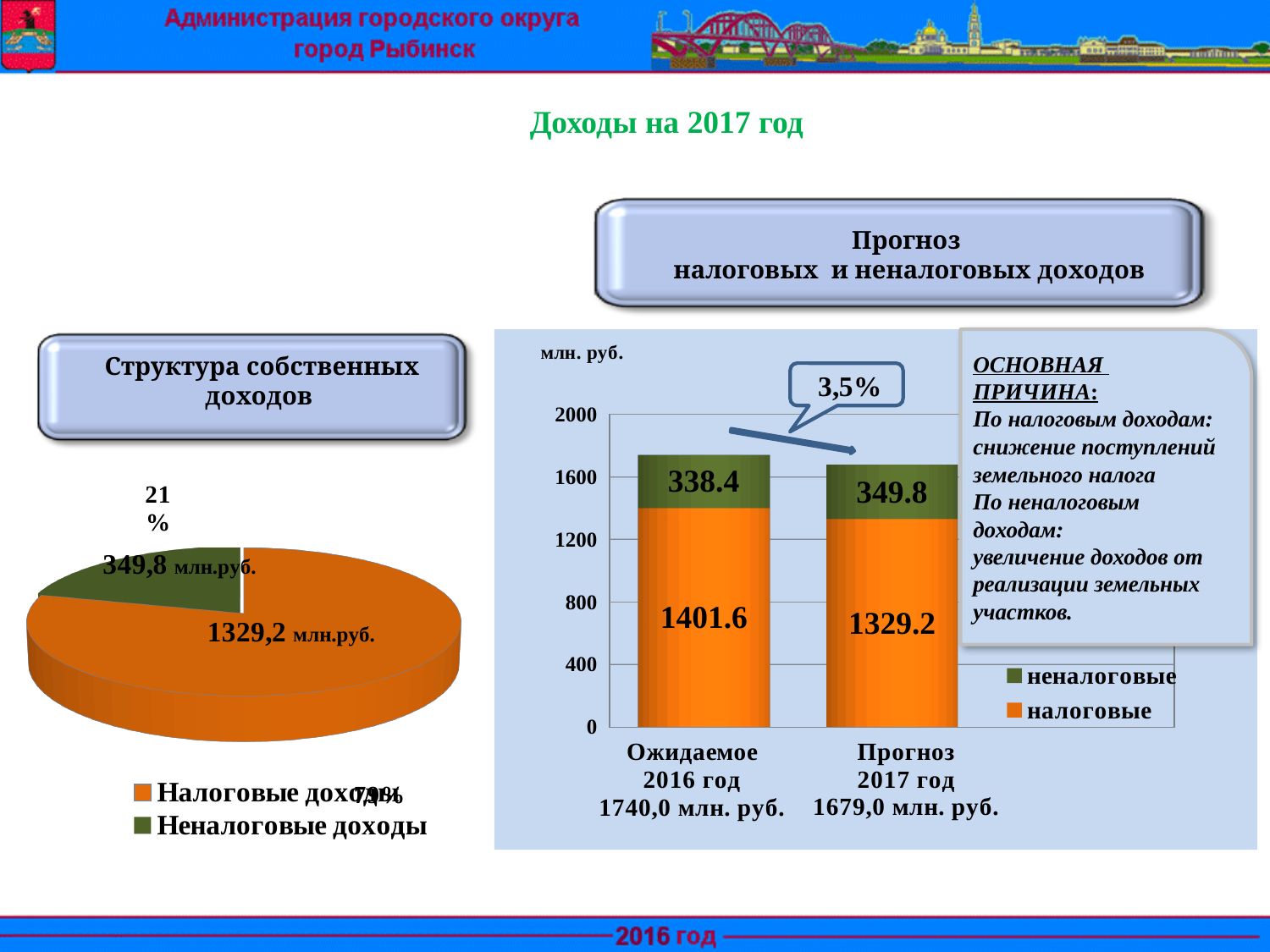
In the bar chart on the right, what is the value of неналоговые for Прогноз 2017 год? 349.8 In the bar chart on the right, what is the total shown for Ожидаемое 2016 год? 1740,0 млн. руб. In the bar chart on the right, what is the total shown for Прогноз 2017 год? 1679,0 млн. руб. In the bar chart on the right, what is the difference between the налоговые values for 2016 and 2017? 72.4 In the bar chart on the right, what percentage change is shown in the callout above the bars? 3,5% In the pie chart on the left, what share of the pie is Неналоговые доходы? 21% In the bar chart on the right, what is the value of налоговые for Ожидаемое 2016 год? 1401.6 In the pie chart on the left, what is the value of Неналоговые доходы? 349,8 млн.руб. What kind of chart is the one on the left titled Структура собственных доходов? pie chart In the bar chart on the right, does the налоговые value rise or fall from 2016 to 2017? fall In the bar chart on the right, how many series does the legend list? 2 In the bar chart on the right, which year has the larger неналоговые value, 2016 or 2017? Прогноз 2017 год